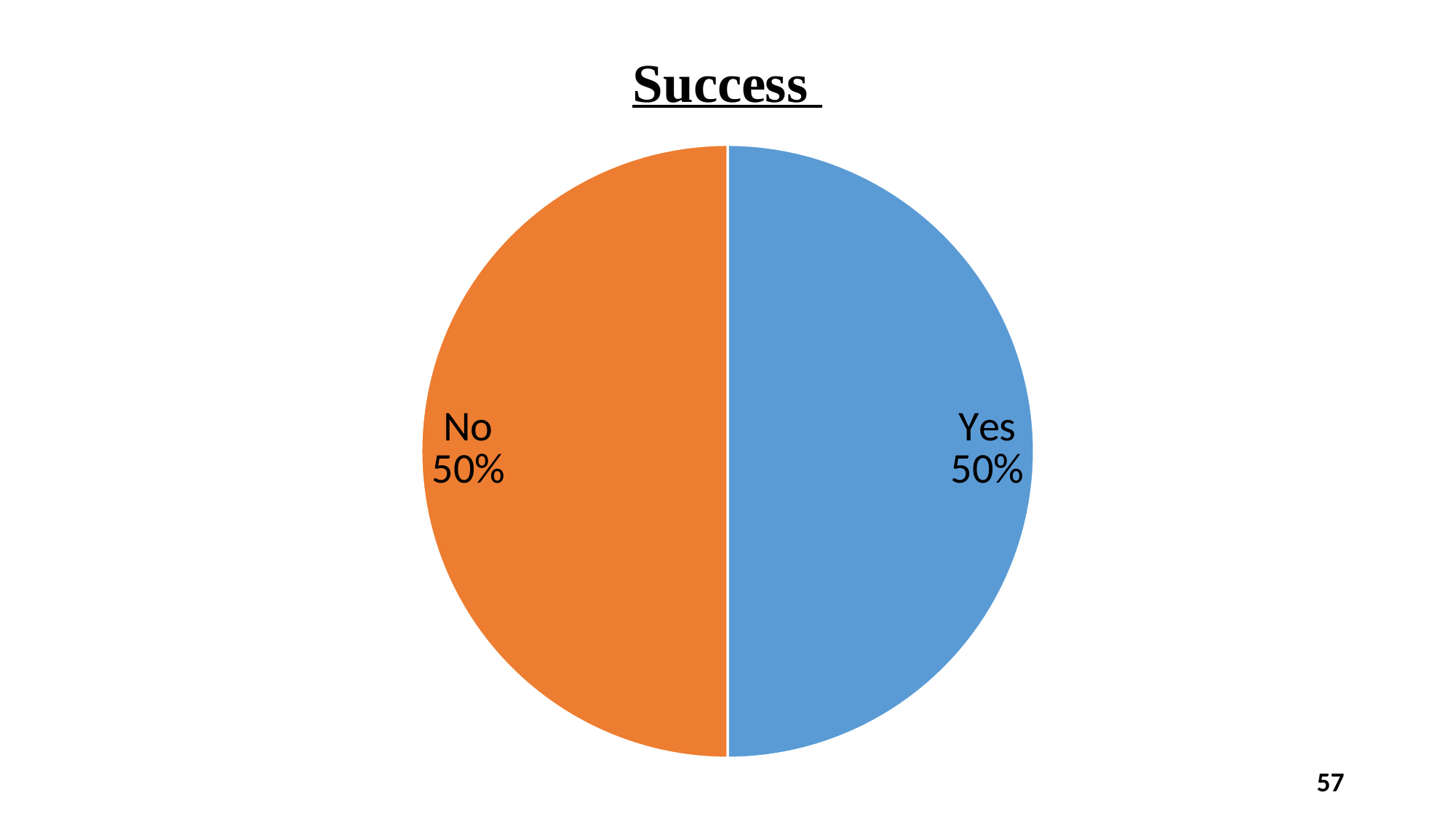
What is the title of the chart? Success What share of the pie does the "Yes" slice represent? 50% What is the combined share of the "Yes" and "No" slices? 100% What kind of chart is shown on the slide? pie chart What share of the pie does the "No" slice represent? 50% How many slices does the pie chart have? 2 What is the difference between the "Yes" share and the "No" share? 0% What colour is the "No" slice? orange